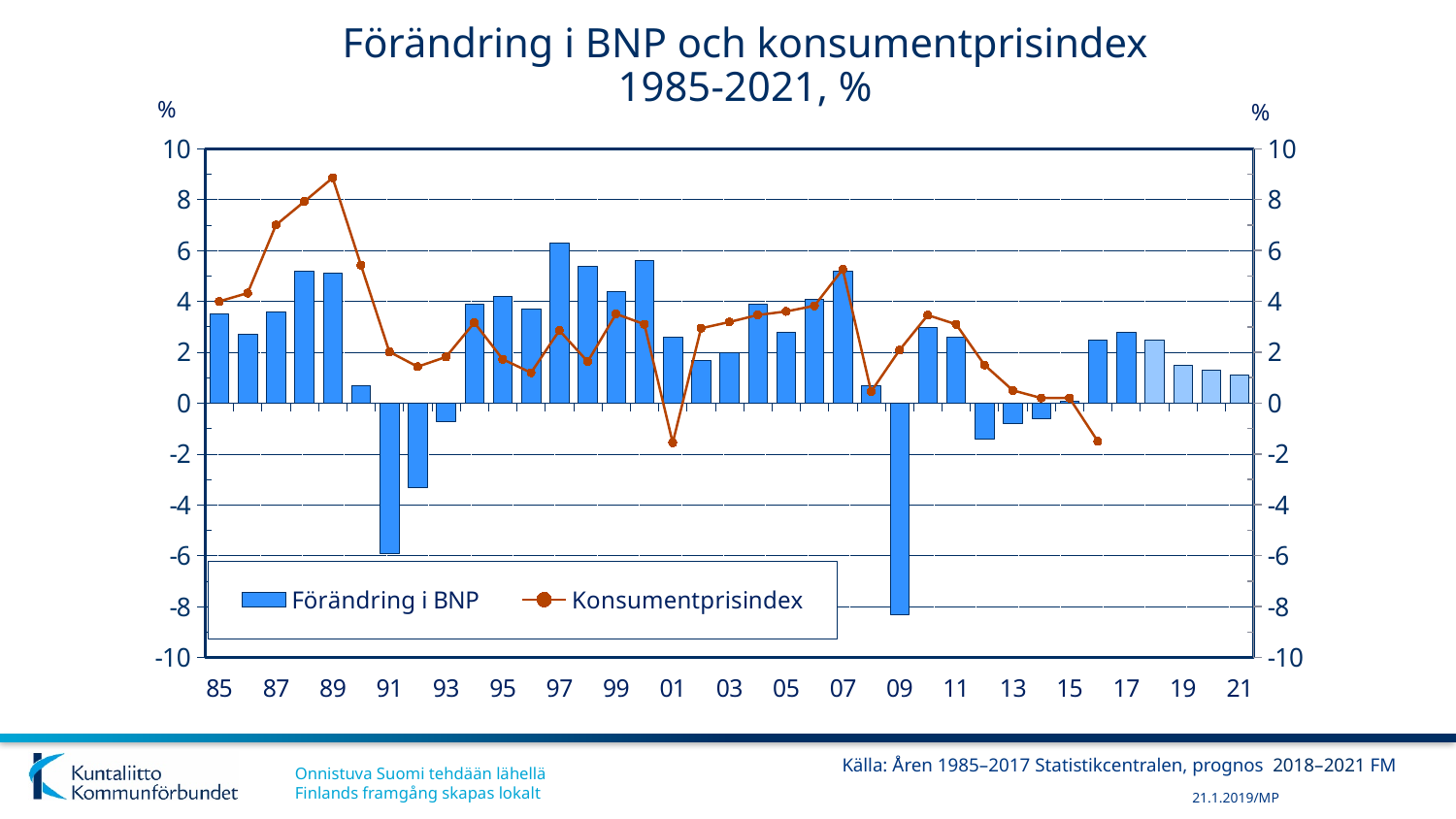
What kind of chart is shown on the slide? A combined bar and line chart What is the title of the chart? Förändring i BNP och konsumentprisindex 1985-2021, % In which year does the Konsumentprisindex line reach its highest value? 1989 Is the Konsumentprisindex value for 2001 greater or less than 0? less In which year is the Förändring i BNP bar lowest? 2009 How many series does the legend list? 2 Which year has the lower Förändring i BNP value, 1991 or 2009? 2009 Is the Förändring i BNP value for 1997 greater or less than 4? greater Is the Konsumentprisindex value for 1989 greater or less than 8? greater Does the Konsumentprisindex line rise or fall from 1985 to 1989? rise What are the two series named in the legend? Förändring i BNP and Konsumentprisindex